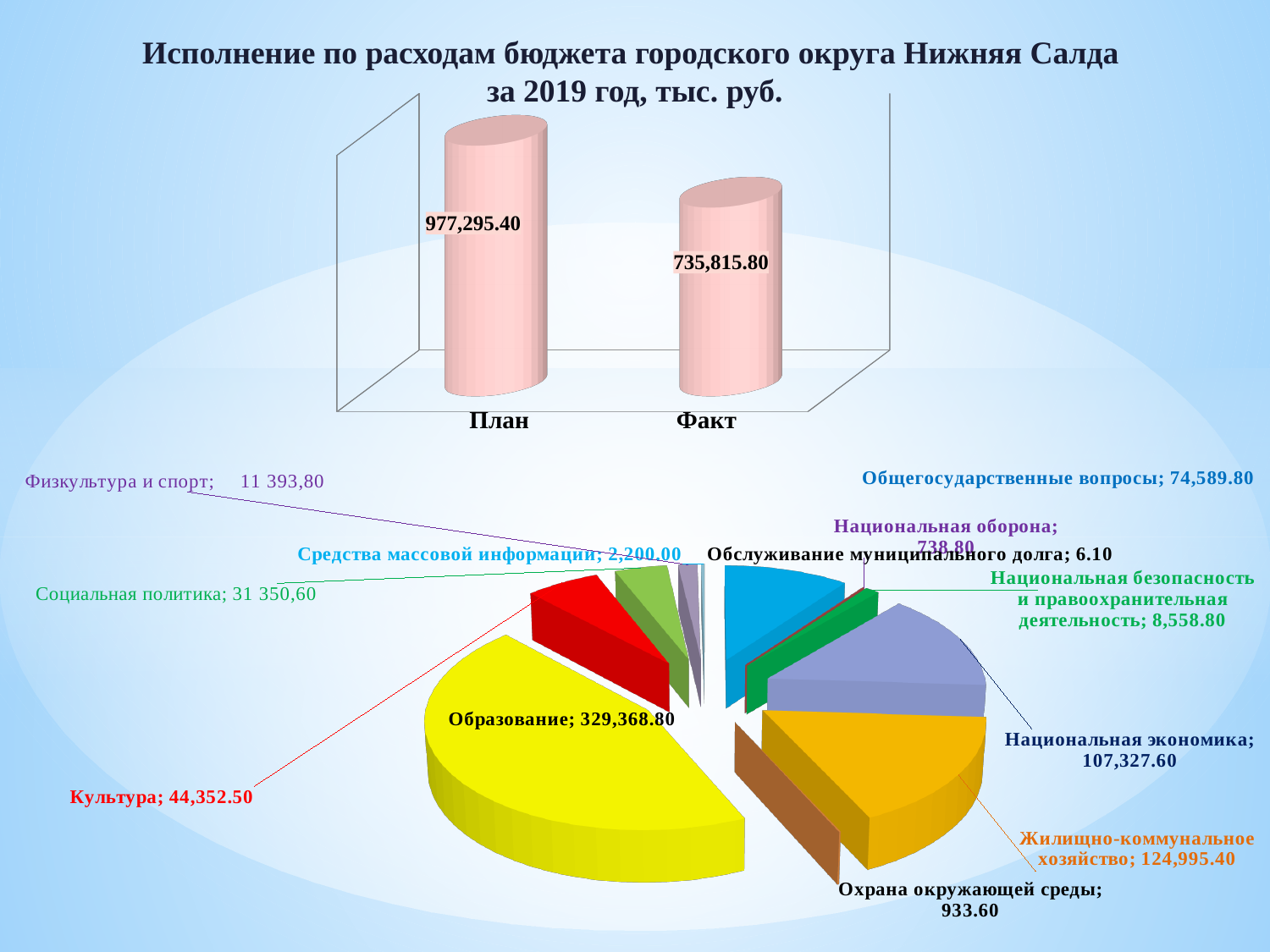
What kind of chart is the bottom chart on the slide? Pie chart What kind of chart is the top chart on the slide? Bar chart In the bottom pie chart, what is the value for Образование? 329,368.80 In the bottom pie chart, which category has the largest value? Образование In the top bar chart, which is larger, План or Факт? План In the bottom pie chart, which category has the smallest value? Обслуживание муниципального долга In the top bar chart, what is the value for План? 977,295.40 In the top bar chart, what is the value for Факт? 735,815.80 In the bottom pie chart, what is the difference between Жилищно-коммунальное хозяйство and Национальная экономика? 17,667.80 In the top bar chart, what is the difference between План and Факт? 241,479.60 How many categories are shown in the bottom pie chart? 12 In the bottom pie chart, what is the value for Жилищно-коммунальное хозяйство? 124,995.40